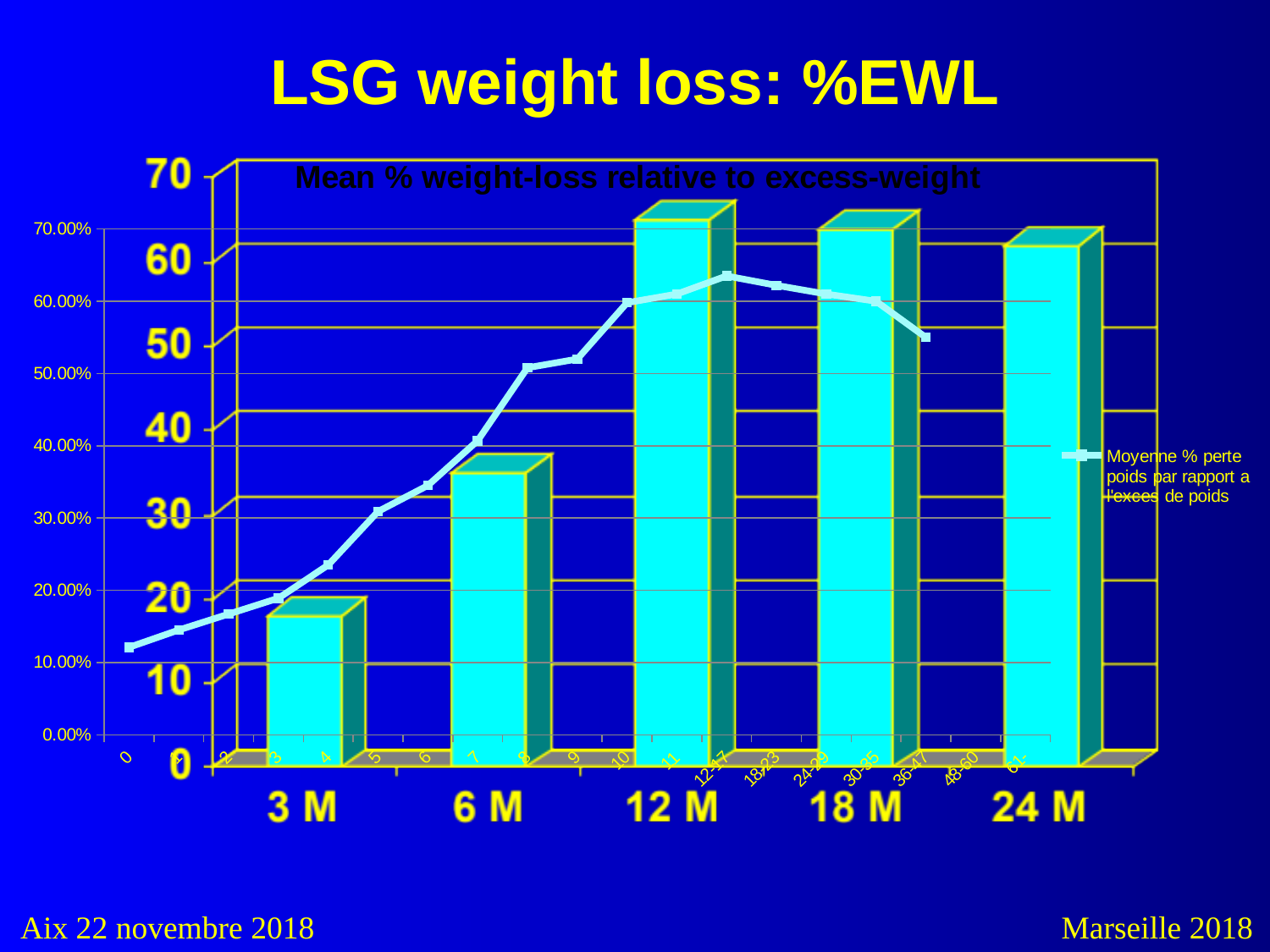
On the bar chart, is the value for 6 M greater or less than 30? greater On the bar chart, is the value for 24 M greater or less than 50? greater On the bar chart, which is larger, the bar for 6 M or the bar for 3 M? 6 M What is the title of the bar chart? Mean % weight-loss relative to excess-weight On the bar chart, which category has the highest bar? 12 M On the bar chart, is the value for 12 M greater or less than 60? greater How many bars are shown on the bar chart? 5 On the bar chart, do the values rise or fall from 3 M to 12 M? rise On the bar chart, which is larger, the bar for 12 M or the bar for 24 M? 12 M On the bar chart, which category has the lowest bar? 3 M